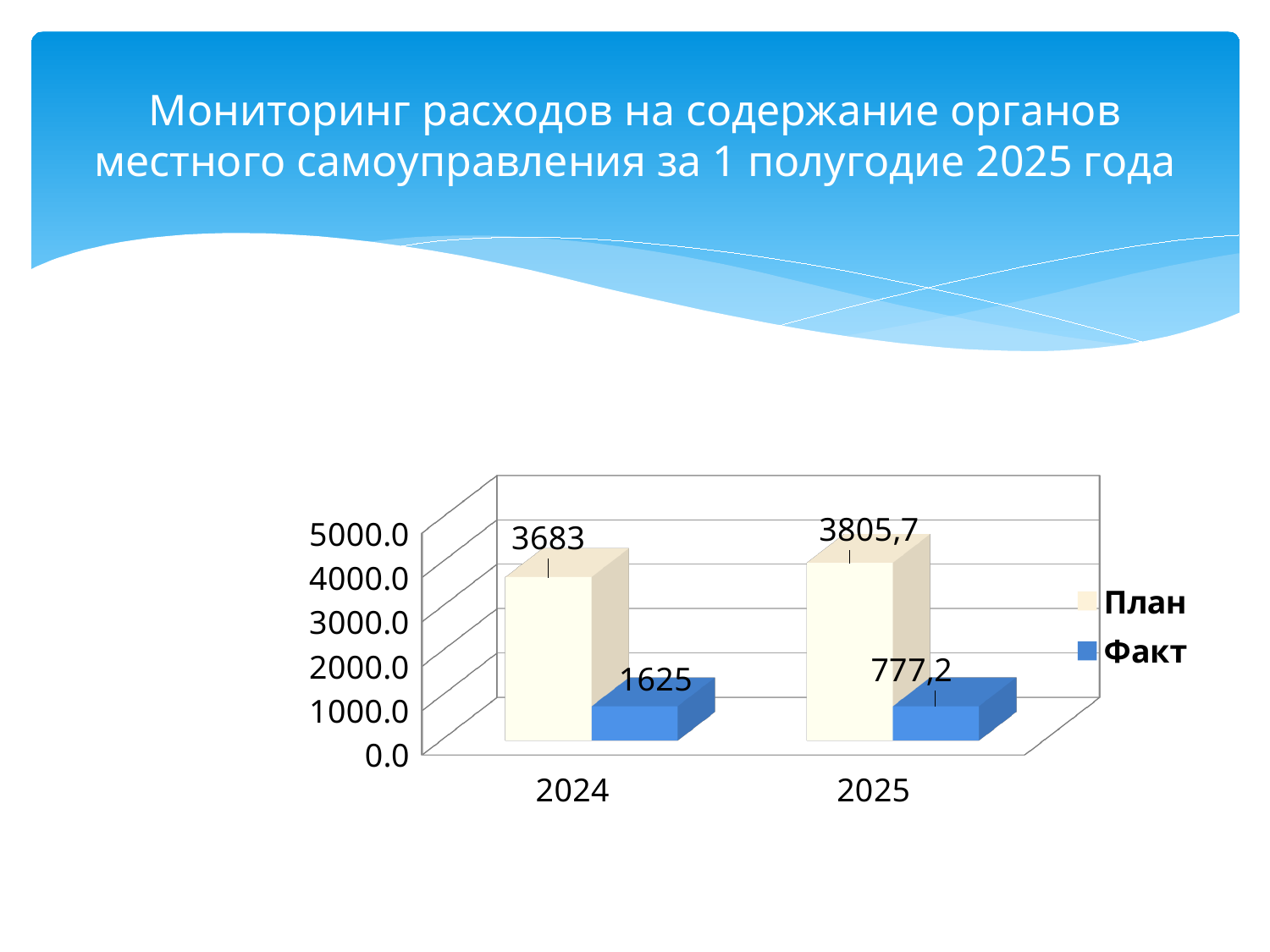
Which year has the higher Факт value? 2024 What kind of chart is shown on the slide? Bar chart What is the value of Факт for 2025? 777,2 Does the Факт value rise or fall from 2024 to 2025? Fall What is the difference between План and Факт for 2024? 2058 What is the value of Факт for 2024? 1625 What is the difference between План and Факт for 2025? 3028,5 Which year has the lower План value? 2024 How many series does the legend list? 2 What is the value of План for 2024? 3683 What is the value of План for 2025? 3805,7 Which is larger: Факт for 2024 or Факт for 2025? Факт for 2024